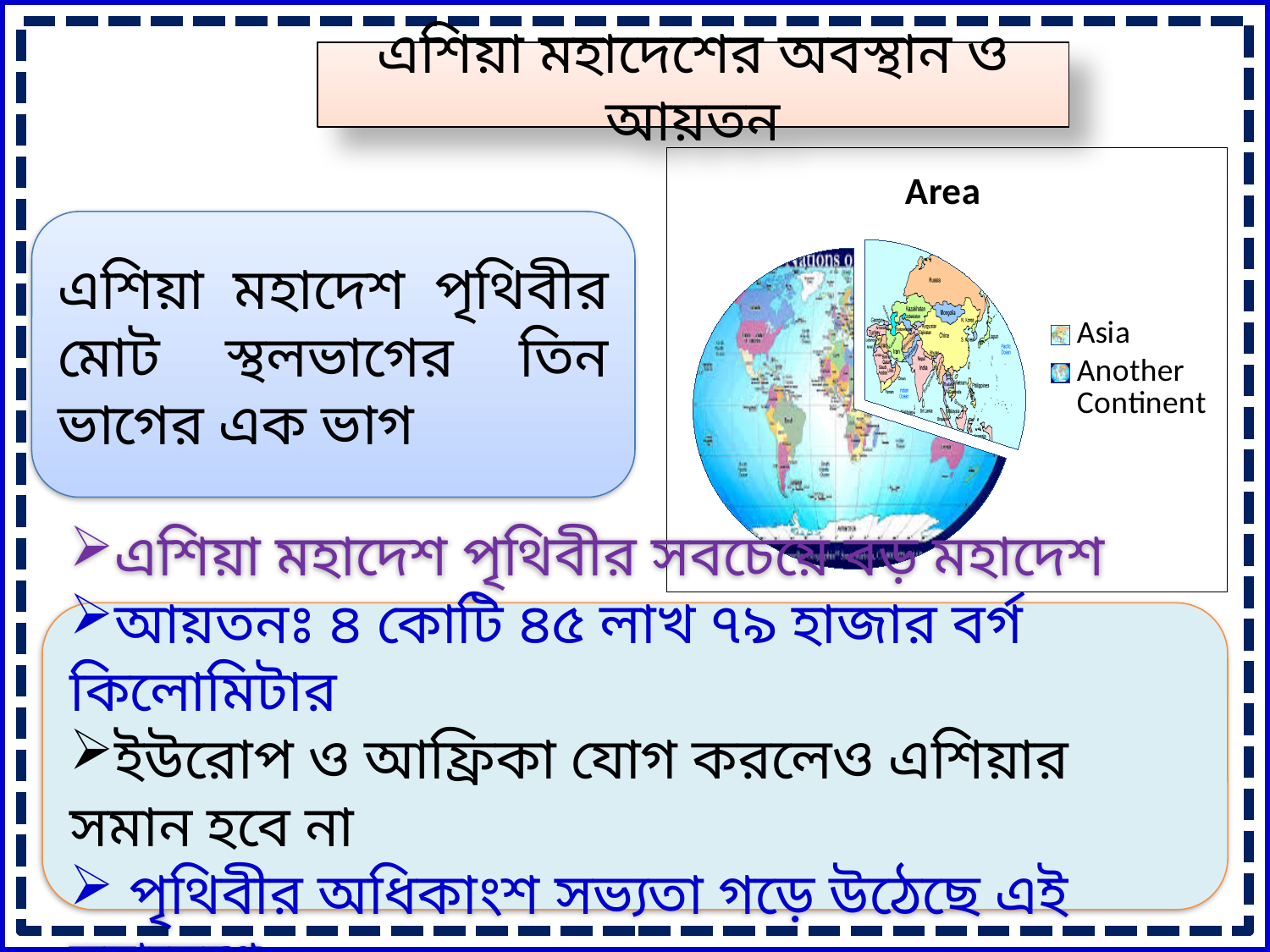
What is the title of the chart on the slide? Area Which category has the smallest slice in the pie chart? Asia What are the two categories listed in the chart's legend? Asia and Another Continent How many slices does the pie chart have? 2 What kind of chart is shown on the slide? pie chart Which category has the largest slice in the pie chart? Another Continent Which slice of the pie chart is larger, Asia or Another Continent? Another Continent How many entries does the chart's legend list? 2